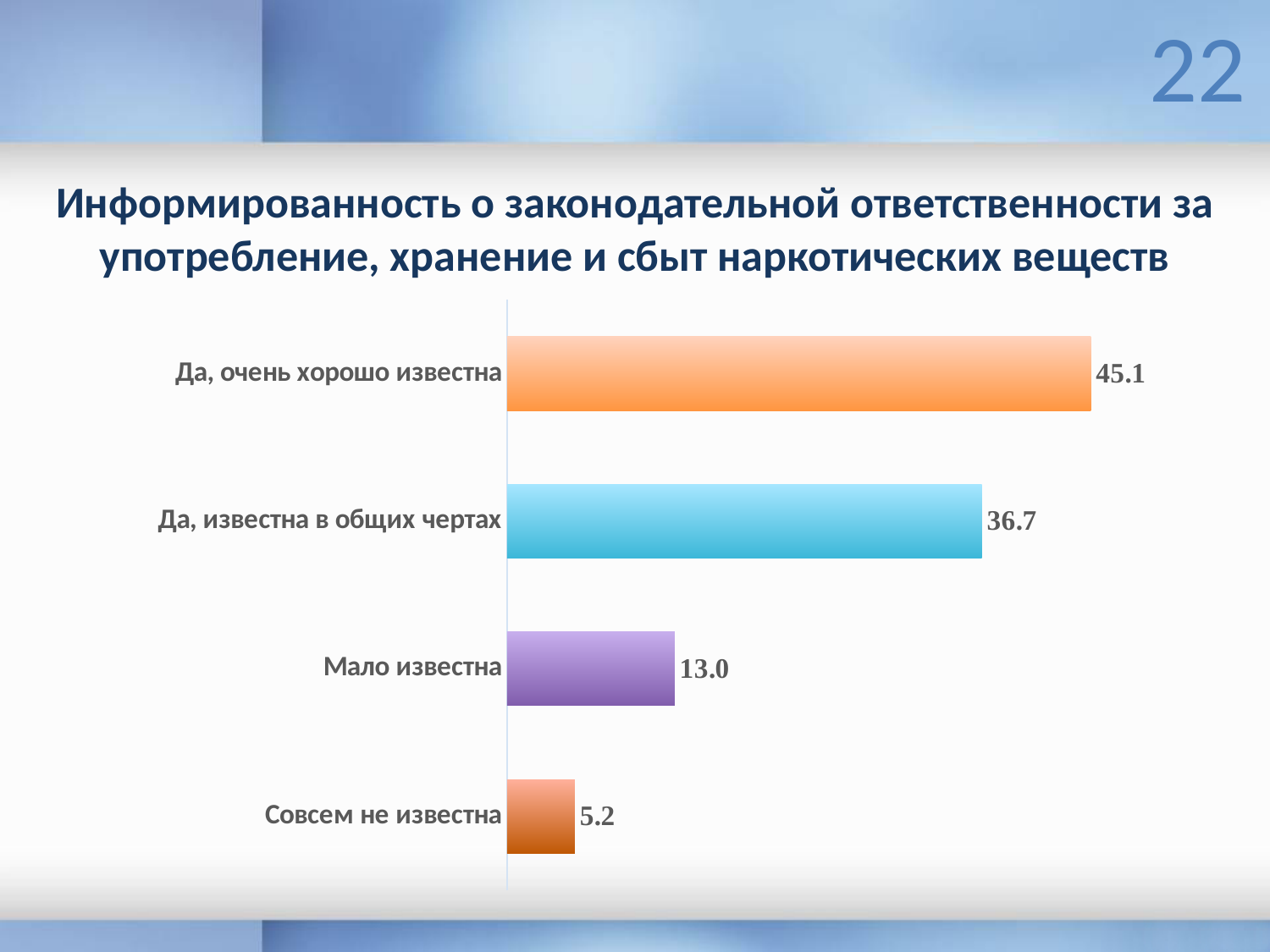
Which is larger, the value for "Мало известна" or the value for "Совсем не известна"? Мало известна What is the value for "Мало известна"? 13.0 How many categories are shown in the chart? 4 What is the value for "Да, очень хорошо известна"? 45.1 What is the difference between the values for "Мало известна" and "Совсем не известна"? 7.8 Which category has the highest value? Да, очень хорошо известна What is the value for "Совсем не известна"? 5.2 Which category has the lowest value? Совсем не известна What is the difference between the values for "Да, очень хорошо известна" and "Да, известна в общих чертах"? 8.4 What is the title of the slide? Информированность о законодательной ответственности за употребление, хранение и сбыт наркотических веществ What is the value for "Да, известна в общих чертах"? 36.7 What kind of chart is shown on the slide? Bar chart